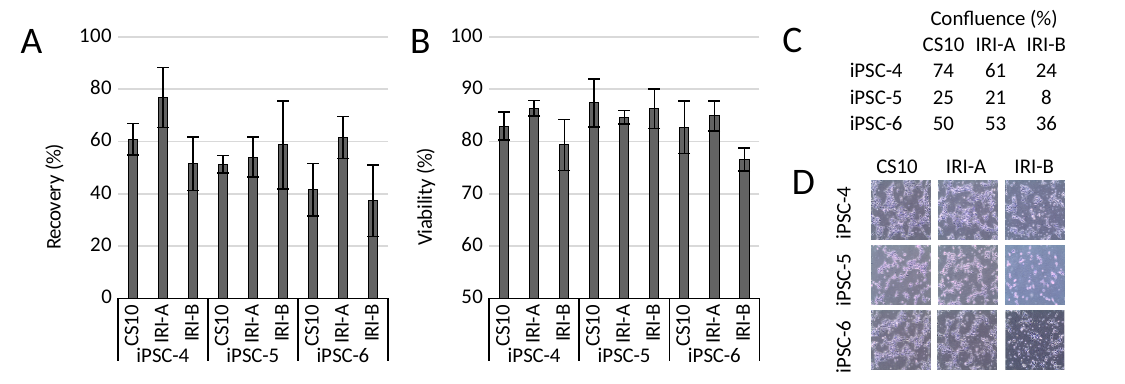
In chart A (Recovery), which bar is the highest? IRI-A for iPSC-4 How many cell-line groups are shown on the x axis of chart B (Viability)? 3 What kind of chart is chart A (Recovery)? bar chart In chart B (Viability), is the value for IRI-B in the iPSC-6 group greater or less than 80? less What is the lowest value shown on the y axis of chart B (Viability)? 50 What is the y-axis label of chart A? Recovery (%) In chart A (Recovery), is the value for IRI-A in the iPSC-4 group greater or less than 70? greater In chart A (Recovery), is the value for CS10 in the iPSC-6 group greater or less than 50? less How many bars are plotted in chart A (Recovery)? 9 In chart A (Recovery), which is larger for iPSC-4: IRI-A or IRI-B? IRI-A In chart B (Viability), which is larger for iPSC-6: IRI-A or IRI-B? IRI-A